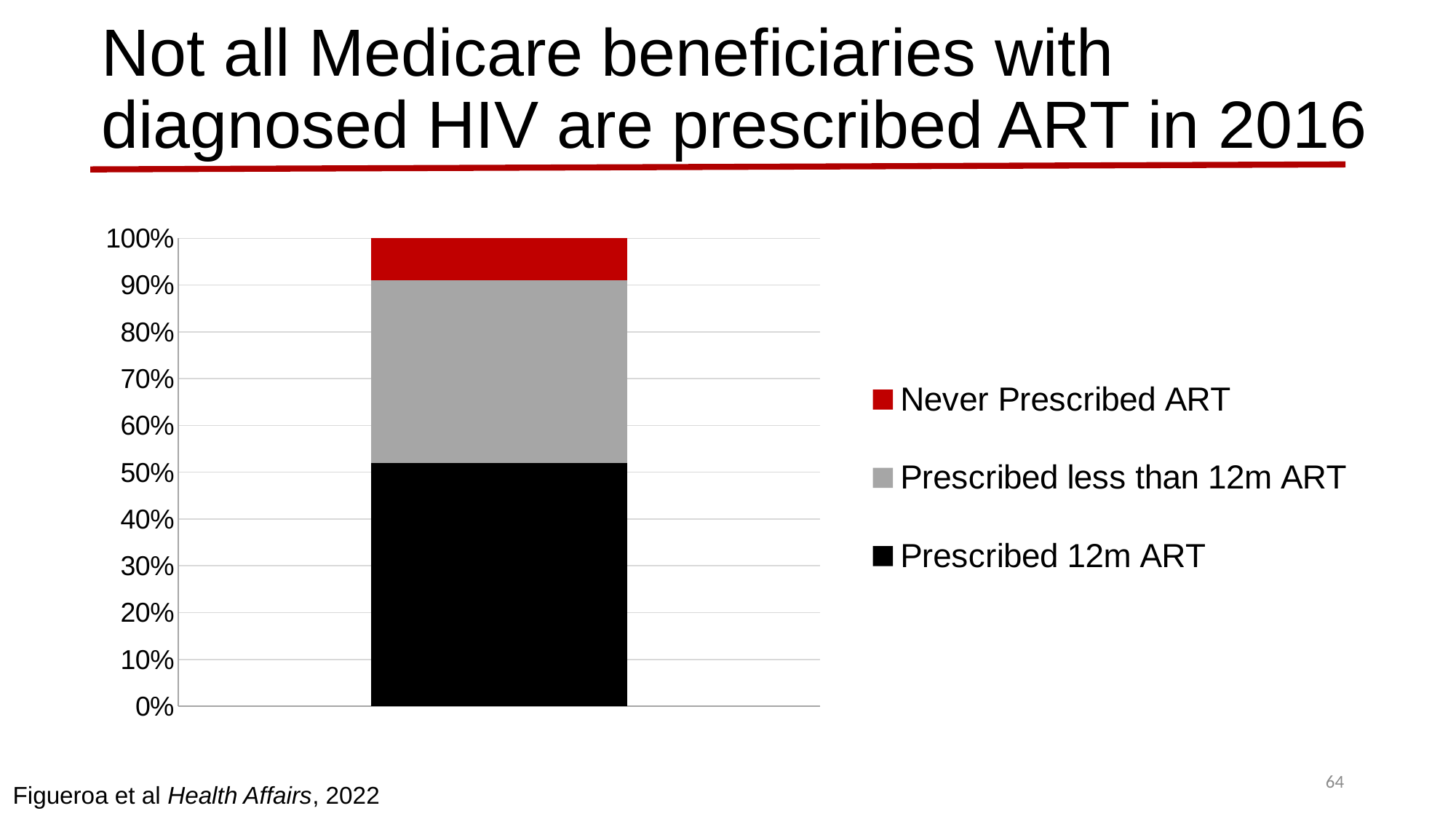
Is the value for Prescribed 12m ART greater or less than 40%? greater How many series does the legend list? 3 What is the total height of the stacked bar? 100% What colour represents Never Prescribed ART in the legend? Red Is the value for Never Prescribed ART greater or less than 20%? less Which is larger, the Prescribed less than 12m ART segment or the Never Prescribed ART segment? Prescribed less than 12m ART Is the value for Prescribed less than 12m ART greater or less than 30%? greater Which segment of the bar is the smallest? Never Prescribed ART How many bars are plotted in the chart? 1 What kind of chart is shown on the slide? Stacked bar chart Which segment of the bar is the largest? Prescribed 12m ART Which is larger, the Prescribed 12m ART segment or the Prescribed less than 12m ART segment? Prescribed 12m ART